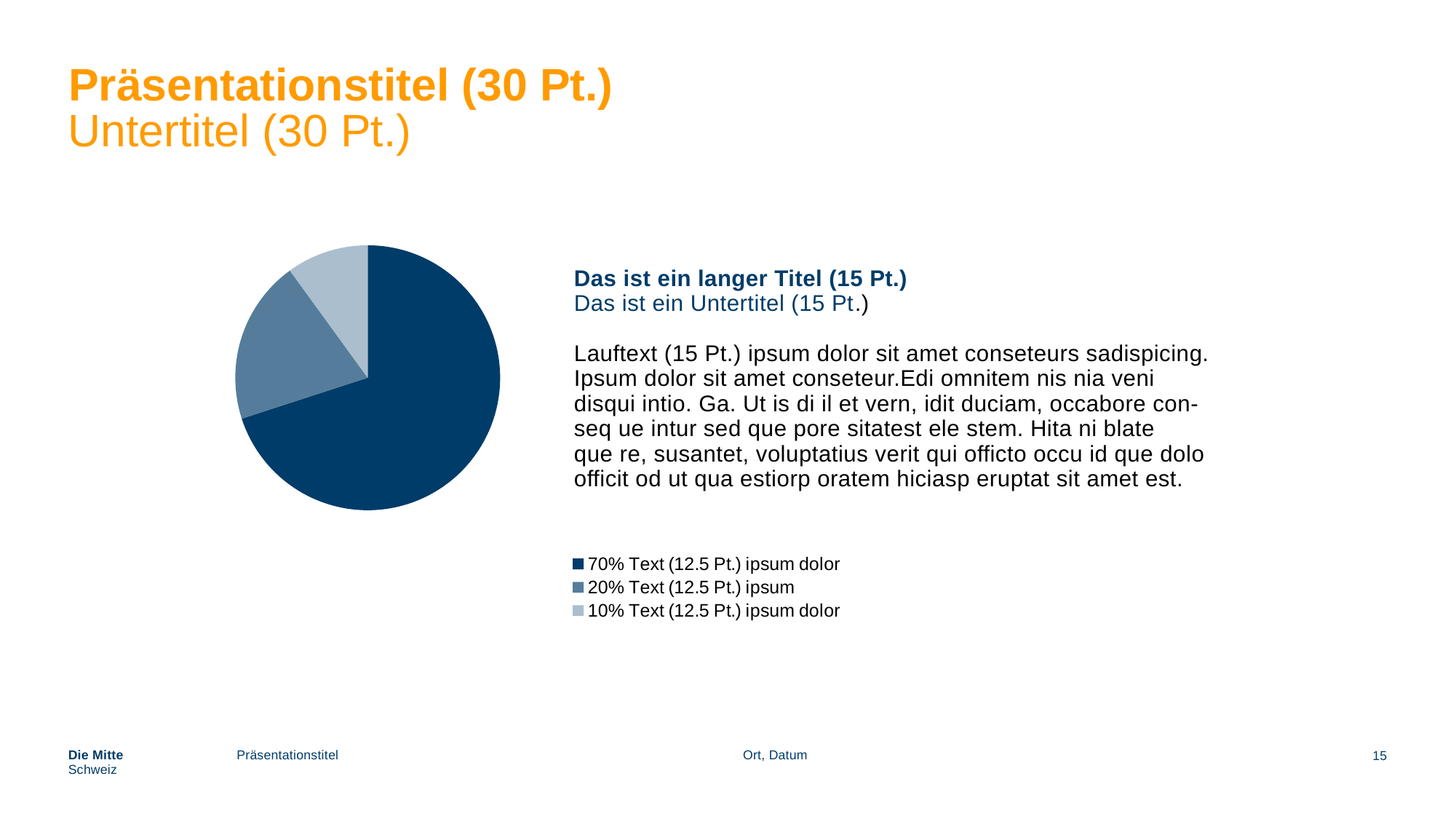
What is the difference in percentage points between the 70% slice and the 20% slice? 50 What share of the pie does the lightest slice represent, according to the legend? 10% How many entries does the legend of the pie chart list? 3 How many slices does the pie chart have? 3 Which legend entry corresponds to the smallest slice of the pie chart? 10% Text (12.5 Pt.) ipsum dolor What kind of chart is shown on the slide? pie chart What colour is the largest slice of the pie chart? dark blue What is the difference in percentage points between the largest and the smallest slice of the pie chart? 60 What share of the pie does the dark blue slice represent, according to the legend? 70% Is the slice labelled '20% Text (12.5 Pt.) ipsum' larger or smaller than the slice labelled '10% Text (12.5 Pt.) ipsum dolor'? larger Which legend entry corresponds to the largest slice of the pie chart? 70% Text (12.5 Pt.) ipsum dolor What share of the pie does the medium blue slice represent, according to the legend? 20%